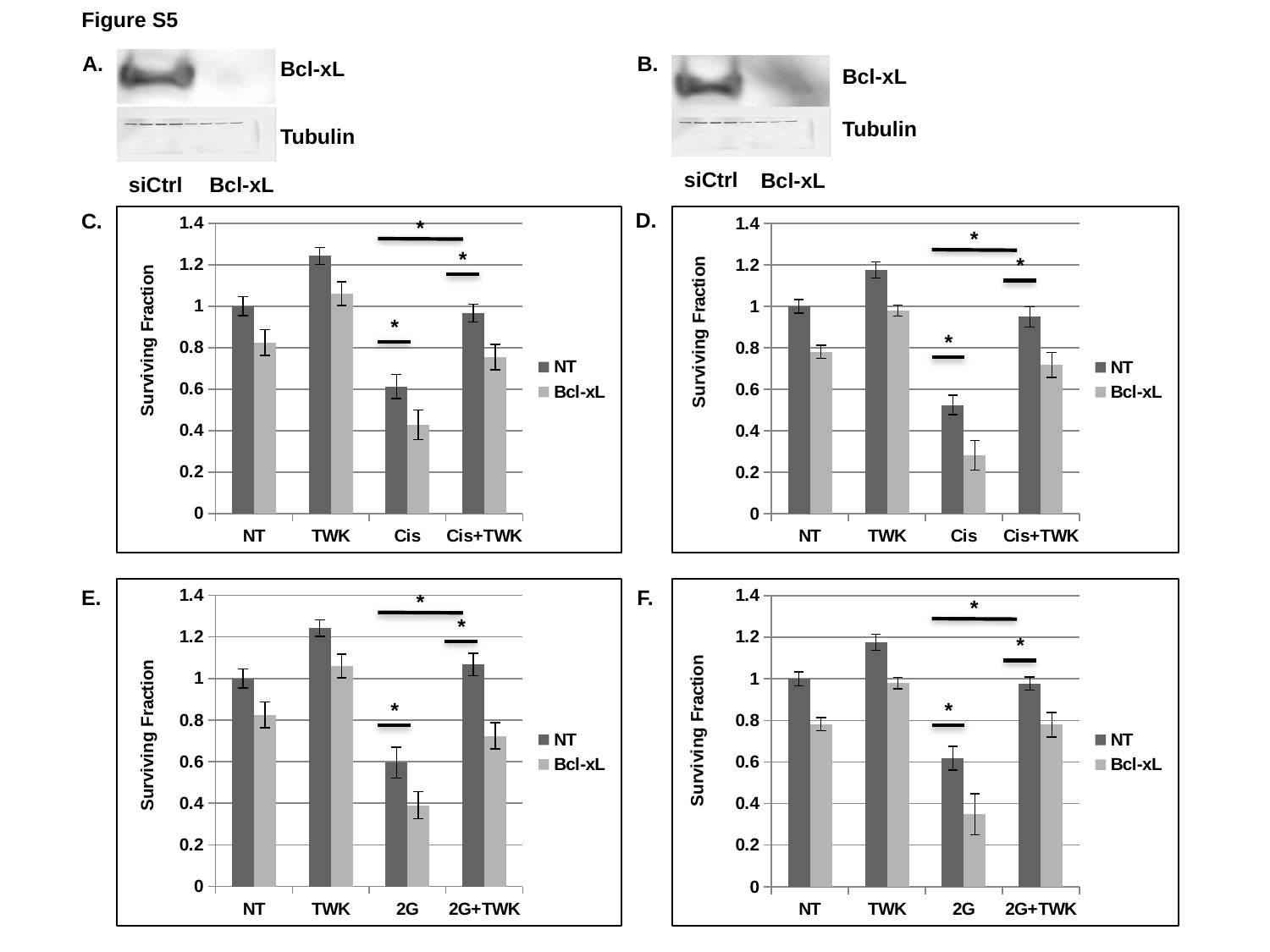
In chart D (top right), what is the title of the y axis? Surviving Fraction In chart D (top right), how many series does the legend list? 2 In chart C (top left), which category has the highest NT bar? TWK In chart C (top left), is the NT value for Cis greater or less than 0.4? greater In chart C (top left), what kind of chart is shown? bar chart In chart E (bottom left), is the NT value for TWK greater or less than 1? greater In chart E (bottom left), which category has the lowest Bcl-xL bar? 2G In chart F (bottom right), at TWK, which series has the larger value, NT or Bcl-xL? NT In chart C (top left), which category has the lowest Bcl-xL bar? Cis In chart C (top left), how many categories are shown on the x axis? 4 In chart F (bottom right), is the Bcl-xL value for 2G+TWK greater or less than 1? less